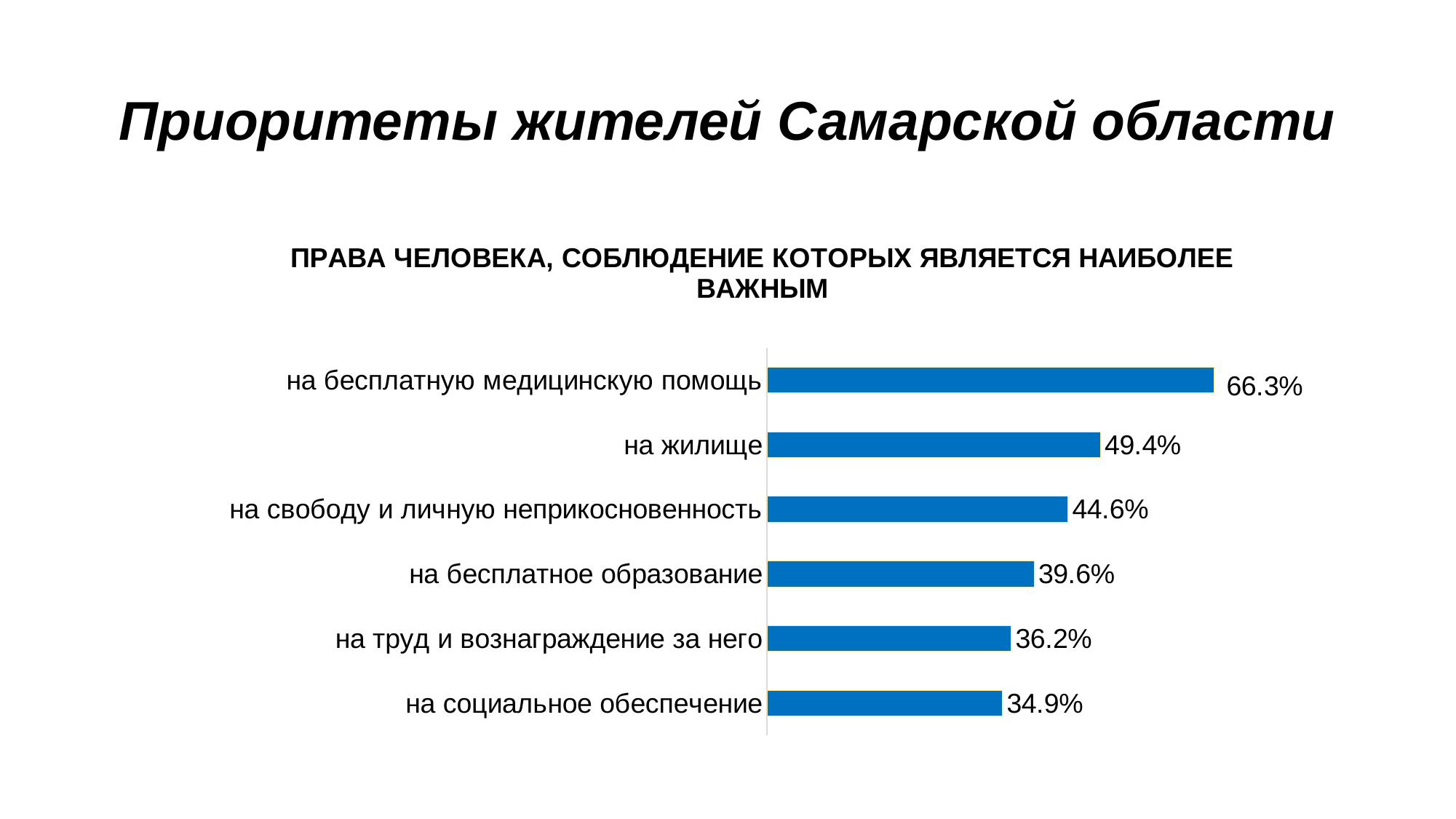
What is the value for "на социальное обеспечение"? 34.9% What is the value for "на жилище"? 49.4% How many categories are shown in the chart? 6 Which is larger: the value for "на труд и вознаграждение за него" or the value for "на бесплатное образование"? на бесплатное образование Which category has the highest value? на бесплатную медицинскую помощь Which category has the lowest value? на социальное обеспечение What kind of chart is shown on the slide? bar chart What is the value for "на бесплатное образование"? 39.6% What is the value for "на бесплатную медицинскую помощь"? 66.3% What is the title of the chart? ПРАВА ЧЕЛОВЕКА, СОБЛЮДЕНИЕ КОТОРЫХ ЯВЛЯЕТСЯ НАИБОЛЕЕ ВАЖНЫМ What is the value for "на свободу и личную неприкосновенность"? 44.6% What is the difference between the values for "на бесплатную медицинскую помощь" and "на жилище"? 16.9%